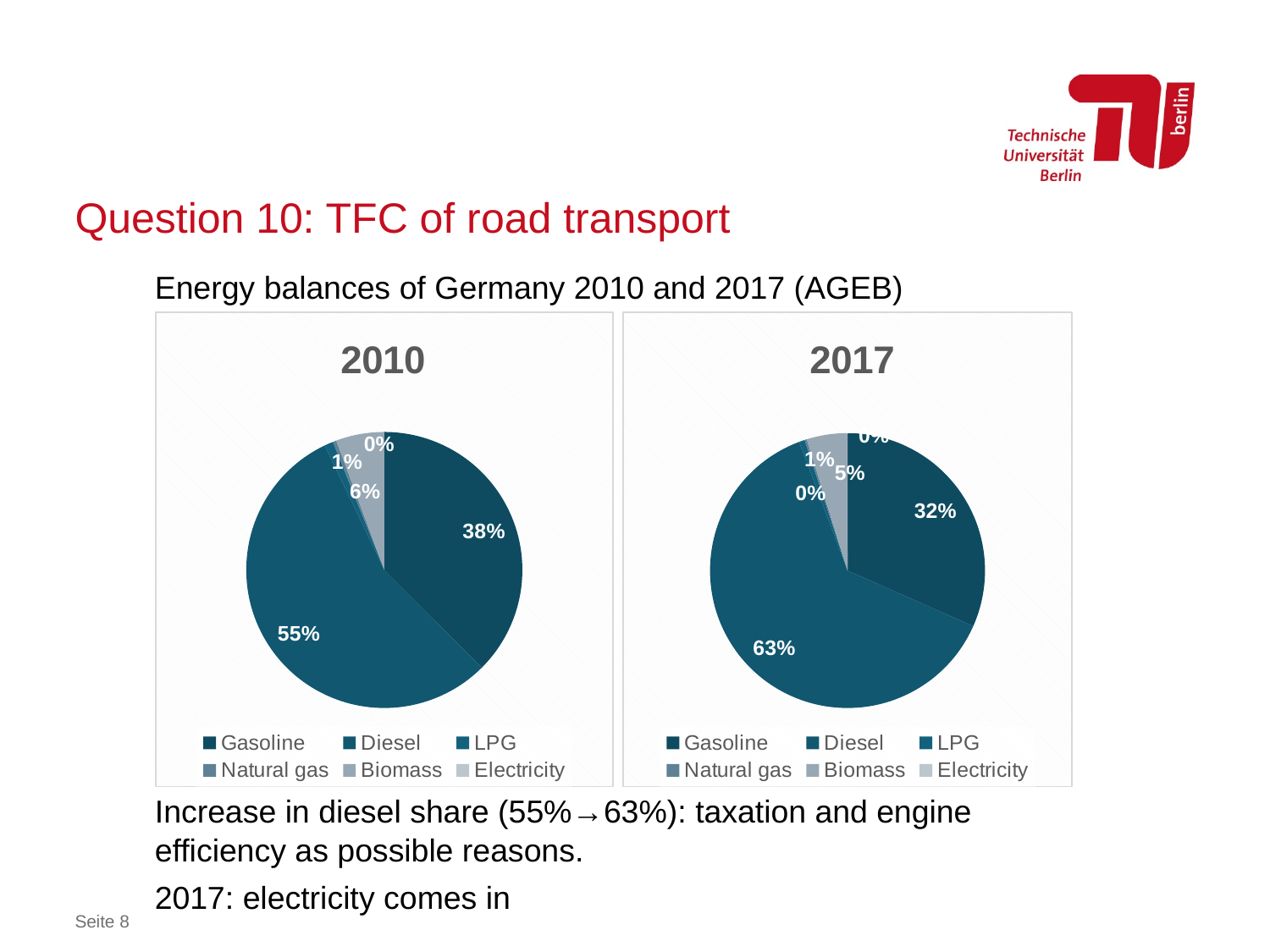
In the 2010 pie chart, what is the difference between the Diesel share and the Gasoline share? 17 percentage points What type of chart is used for the 2010 and 2017 data? Pie chart In the 2010 pie chart, what share does Diesel have? 55% In the 2010 pie chart, what share does Gasoline have? 38% How many pie charts are shown on the slide? 2 In the 2010 pie chart, which category has the largest slice? Diesel In the 2017 pie chart, what share does Gasoline have? 32% Is the Gasoline share larger in the 2010 chart or the 2017 chart? 2010 How many categories does the legend of the 2017 chart list? 6 In the 2017 pie chart, what share does Diesel have? 63% By how many percentage points did the Diesel share increase from the 2010 chart to the 2017 chart? 8 percentage points In the 2017 pie chart, which category has the largest slice? Diesel